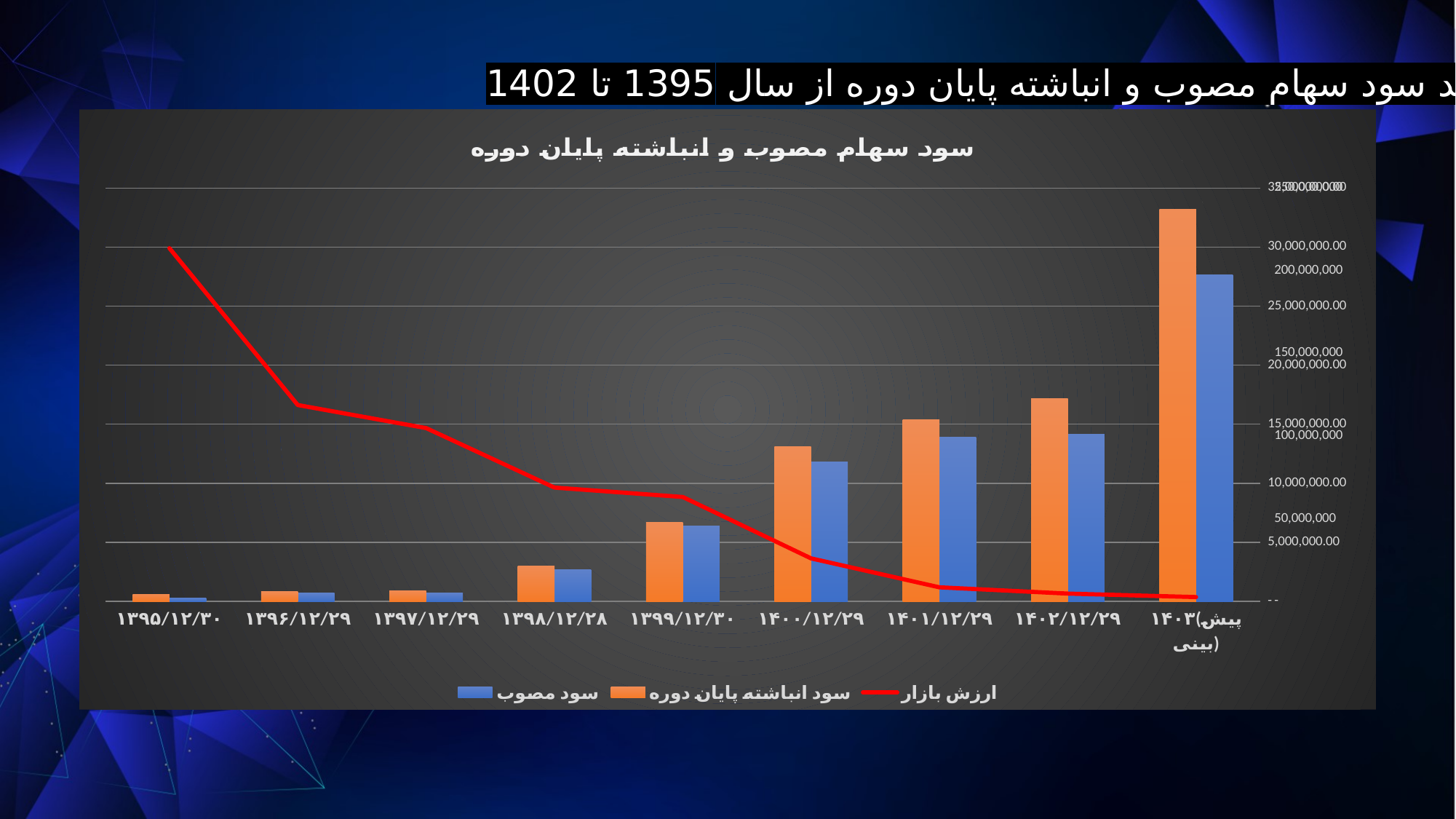
For ۱۴۰۳(پیش بینی), which is larger: سود انباشته پایان دوره or سود مصوب? سود انباشته پایان دوره What is the title of the chart? سود سهام مصوب و انباشته پایان دوره Which category has the lowest value for سود مصوب? ۱۳۹۵/۱۲/۳۰ Do the سود انباشته پایان دوره bars generally rise or fall from left to right along the x axis? Rise Does the ارزش بازار line rise or fall from left to right along the x axis? Fall Which category has the highest value for سود انباشته پایان دوره? ۱۴۰۳(پیش بینی) Which is larger for سود مصوب: ۱۴۰۰/۱۲/۲۹ or ۱۴۰۲/۱۲/۲۹? ۱۴۰۲/۱۲/۲۹ Which category has the highest value for ارزش بازار? ۱۳۹۵/۱۲/۳۰ What kind of chart is shown on the slide? Combined bar and line chart How many series does the legend list? 3 How many categories are shown along the x axis? 9 Which series is drawn as a red line? ارزش بازار